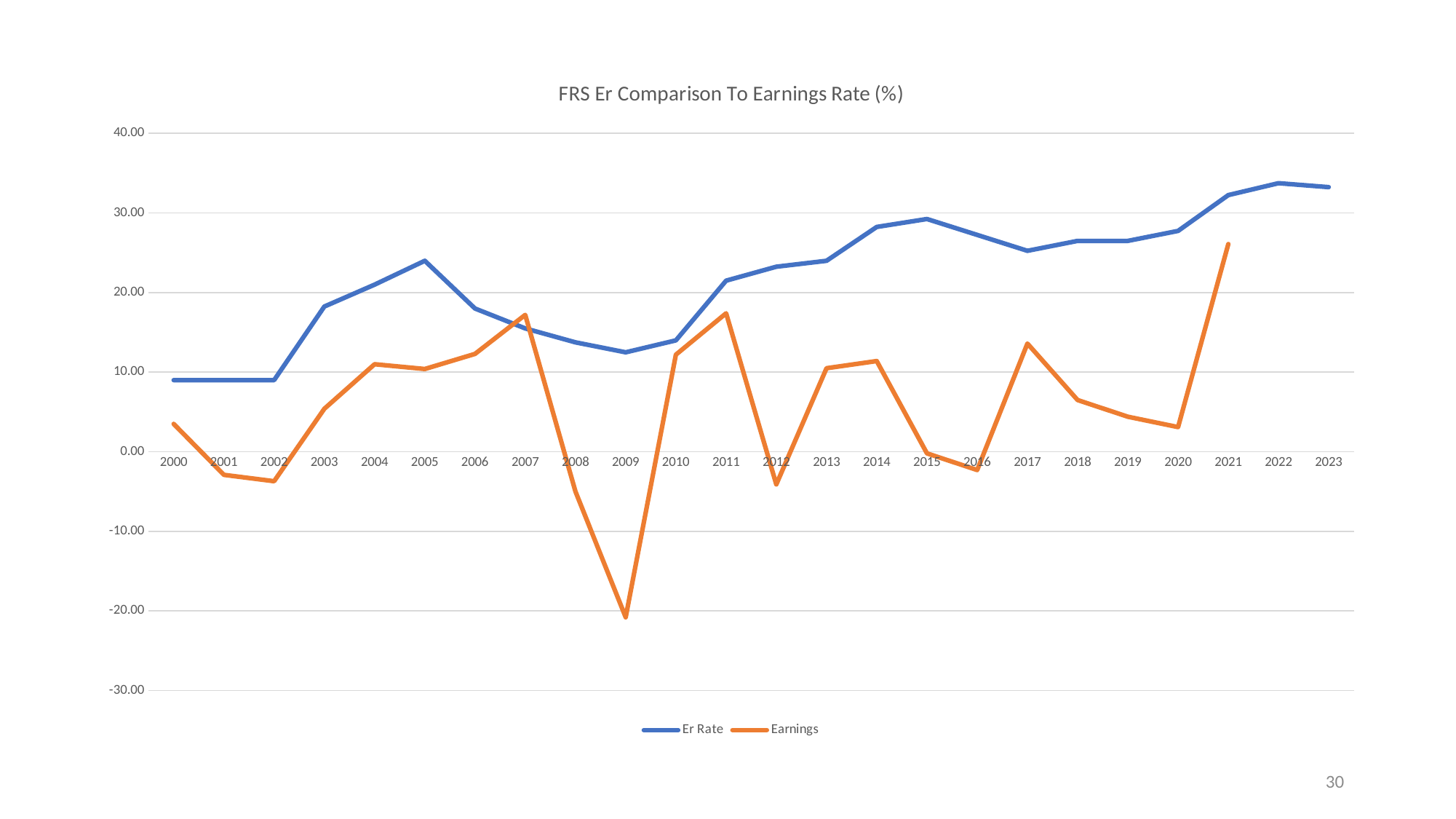
Which colour is used for the Earnings series? orange In 2009, which series has the larger value, Er Rate or Earnings? Er Rate What is the title of the chart? FRS Er Comparison To Earnings Rate (%) What kind of chart is shown on the slide? line chart In which year is the Earnings series at its highest? 2021 Is the Er Rate value for 2005 greater or less than 20.00? greater Is the Er Rate value for 2023 greater or less than 30.00? greater How many series does the legend list? 2 Is the Earnings value for 2009 greater or less than -10.00? less Does the Er Rate series overall rise or fall from 2000 to 2023? rise In which year is the Earnings series at its lowest? 2009 How many years are shown on the x axis? 24